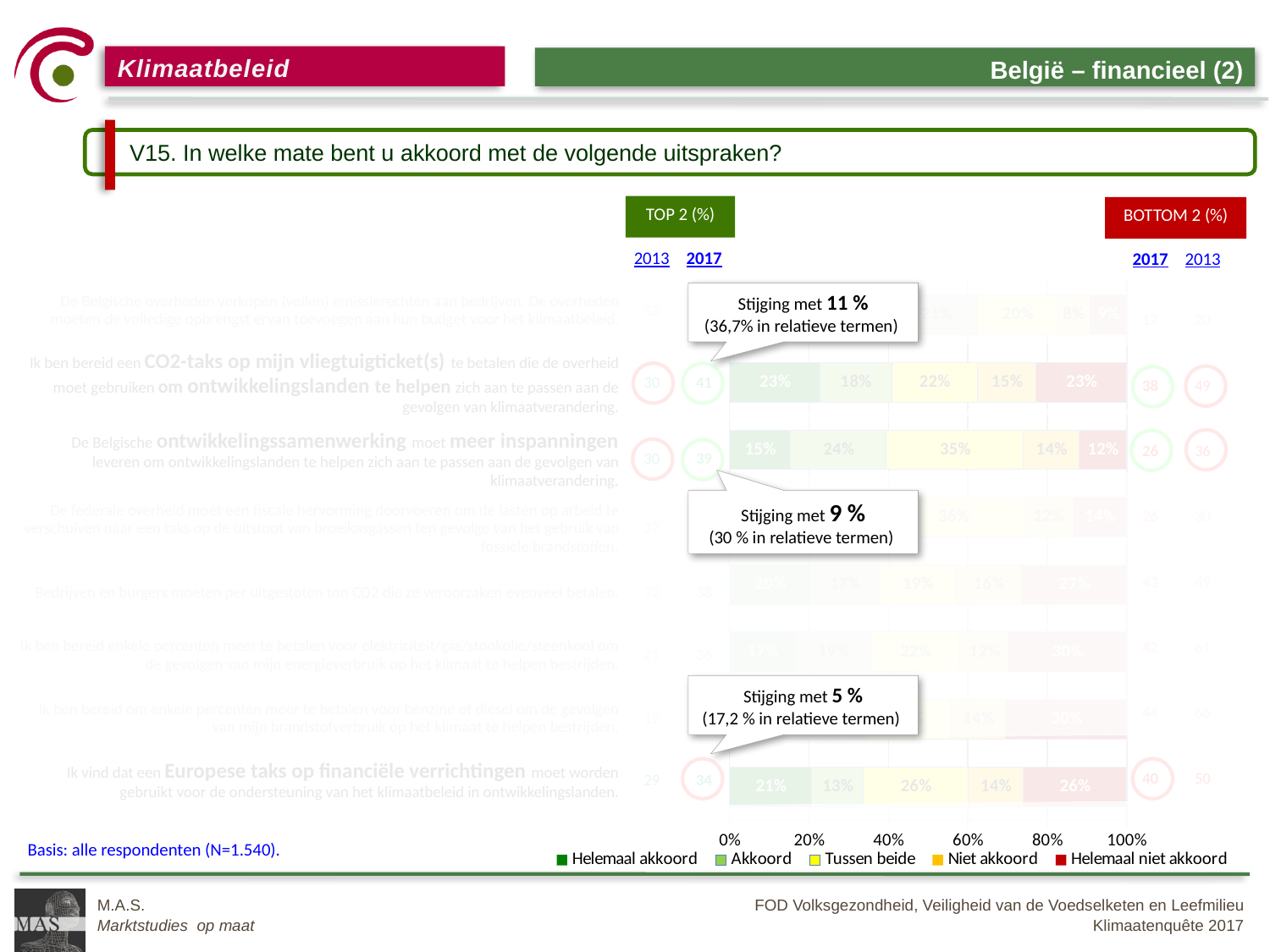
What colour does the legend use for 'Helemaal niet akkoord'? red Which is larger for the statement about a Europese taks op financiële verrichtingen: the 'Helemaal akkoord' value or the 'Akkoord' value? Helemaal akkoord What is the 'Tussen beide' value for the statement about Belgische ontwikkelingssamenwerking? 35% What is the 'Helemaal akkoord' value for the statement about a CO2-taks op mijn vliegtuigticket(s)? 23% What is the difference between the 'Tussen beide' value (35%) and the 'Helemaal akkoord' value (15%) for the statement about Belgische ontwikkelingssamenwerking? 20% What kind of chart is shown on the slide? bar chart What is the 'Helemaal niet akkoord' value for the statement about a Europese taks op financiële verrichtingen? 26% Which of the three highlighted statements has the highest TOP 2 (%) value in 2017? Ik ben bereid een CO2-taks op mijn vliegtuigticket(s) te betalen How many series does the legend list? 5 By how much did the TOP 2 (%) value rise from 2013 to 2017 for the statement about a CO2-taks op mijn vliegtuigticket(s), according to the callout? 11 % What is the TOP 2 (%) value for 2017 for the statement about a CO2-taks op mijn vliegtuigticket(s)? 41 What is the BOTTOM 2 (%) value for 2013 for the statement about a Europese taks op financiële verrichtingen? 50